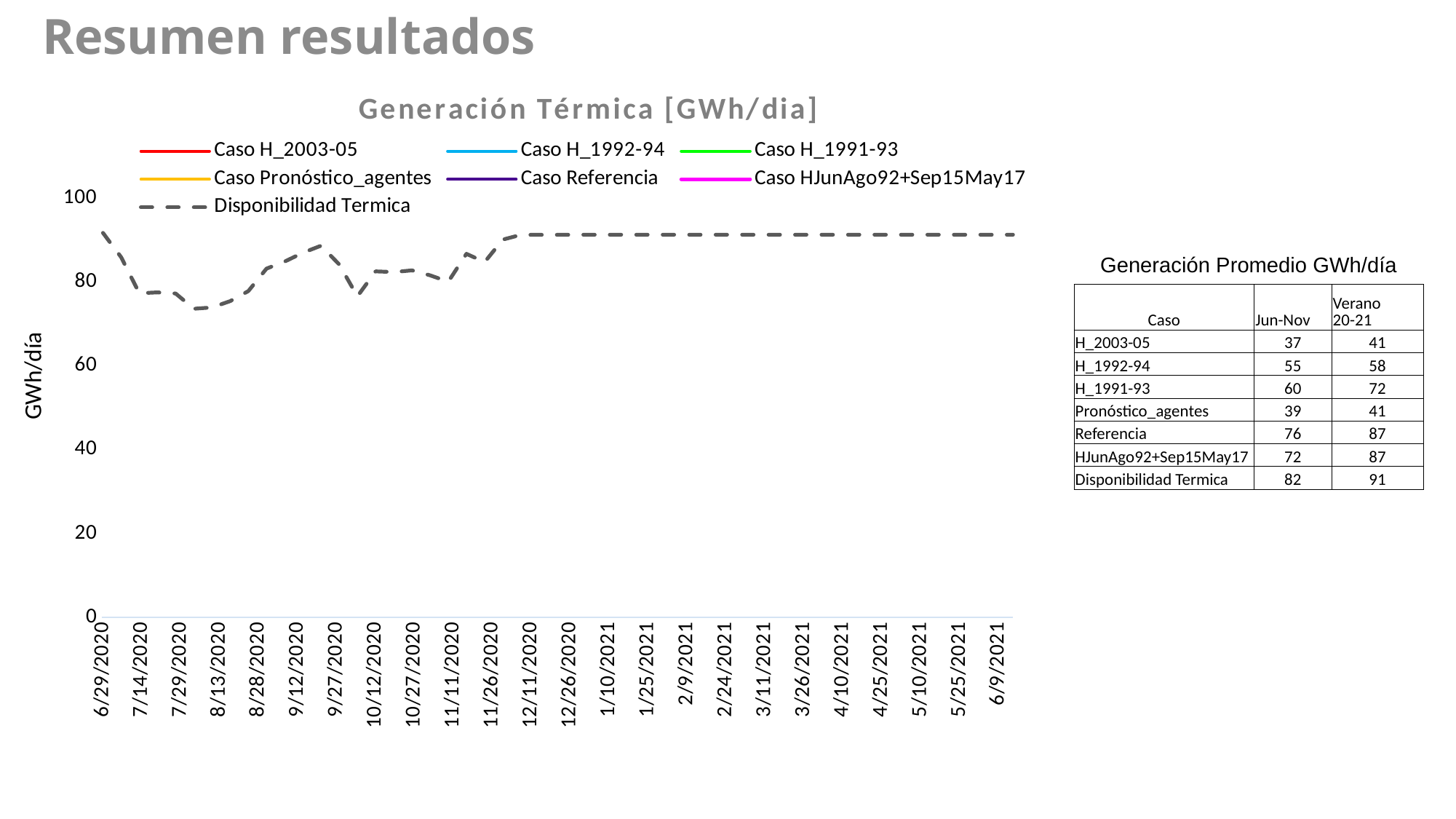
Which is larger for Disponibilidad Termica: the value at 6/29/2020 or the value at 7/29/2020? 6/29/2020 Is the value of Disponibilidad Termica at 6/29/2020 greater or less than 80? greater What kind of chart is shown on the slide? line chart Is the value of Disponibilidad Termica at 6/9/2021 greater or less than 80? greater How many series does the legend of the Generación Térmica chart list? 7 Is the value of Disponibilidad Termica at 12/11/2020 greater or less than 100? less Does the Disponibilidad Termica line rise or fall between 7/29/2020 and 9/12/2020? rise What is the title of the chart? Generación Térmica [GWh/dia] Does the Disponibilidad Termica line rise or fall between 6/29/2020 and 7/29/2020? fall Which series in the chart is drawn as a dashed line? Disponibilidad Termica How many date labels are shown on the x axis of the chart? 24